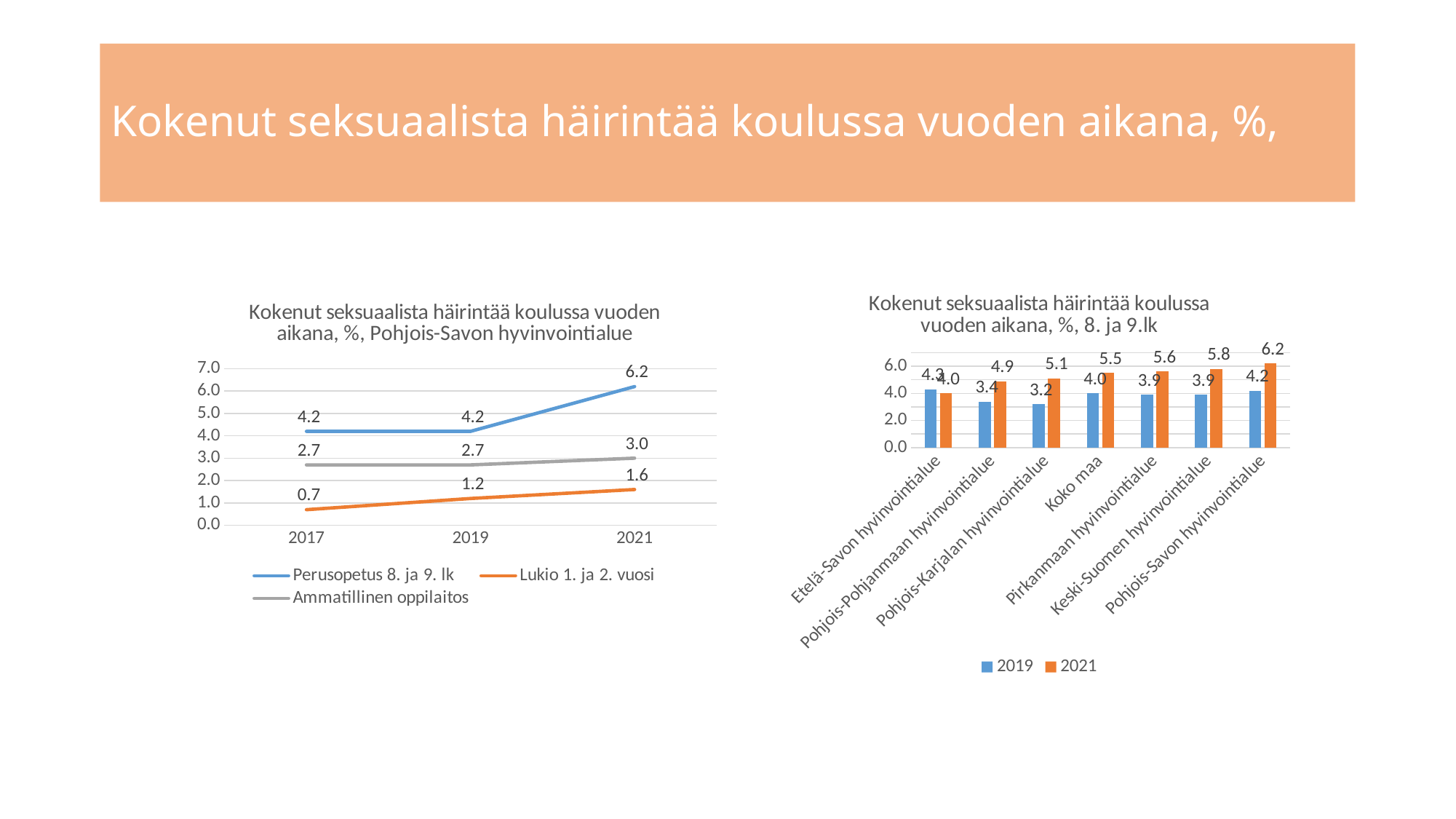
In the left chart (Pohjois-Savon hyvinvointialue), what is the value for Lukio 1. ja 2. vuosi in 2017? 0.7 In the right chart (8. ja 9.lk), which region has the lowest 2019 value? Pohjois-Karjalan hyvinvointialue In the left chart (Pohjois-Savon hyvinvointialue), by how much did the Perusopetus 8. ja 9. lk value change from 2019 to 2021? 2.0 In the left chart (Pohjois-Savon hyvinvointialue), how many series does the legend list? 3 In the left chart (Pohjois-Savon hyvinvointialue), what is the value for Perusopetus 8. ja 9. lk in 2021? 6.2 In the left chart (Pohjois-Savon hyvinvointialue), what is the value for Ammatillinen oppilaitos in 2021? 3.0 What kind of chart is the left chart (Pohjois-Savon hyvinvointialue)? line chart In the right chart (8. ja 9.lk), what is the difference between the 2021 and 2019 values for Pohjois-Karjalan hyvinvointialue? 1.9 In the right chart (8. ja 9.lk), what is the 2021 value for Koko maa? 5.5 In the right chart (8. ja 9.lk), how many regions are shown on the x axis? 7 In the left chart (Pohjois-Savon hyvinvointialue), does the Lukio 1. ja 2. vuosi series rise or fall from 2017 to 2021? rise In the right chart (8. ja 9.lk), which region has the highest 2021 value? Pohjois-Savon hyvinvointialue